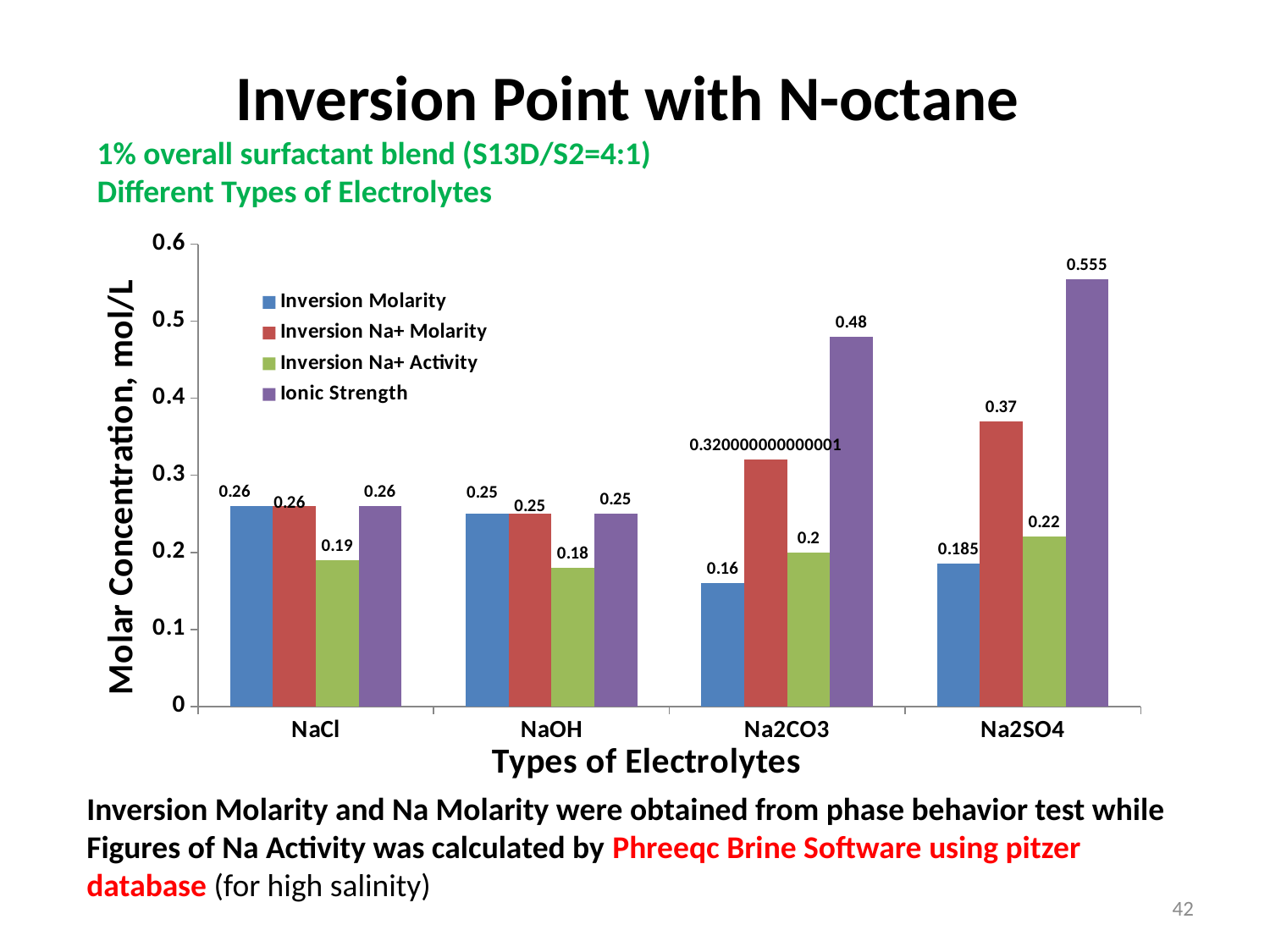
What is the Ionic Strength value for Na2SO4? 0.555 What kind of chart is shown on the slide? Bar chart What is the label of the y axis? Molar Concentration, mol/L Which is larger, the Inversion Na+ Molarity for Na2SO4 or for NaCl? Na2SO4 How many electrolyte types are shown on the x axis? 4 Does the Inversion Molarity generally rise or fall from NaCl to Na2SO4 along the x axis? Fall Which electrolyte has the lowest Inversion Molarity? Na2CO3 What is the difference between the Ionic Strength values for Na2SO4 and Na2CO3? 0.075 How many series does the legend list? 4 What is the Inversion Molarity value for Na2SO4? 0.185 What is the Inversion Na+ Activity value for NaOH? 0.18 Which electrolyte has the highest Ionic Strength? Na2SO4